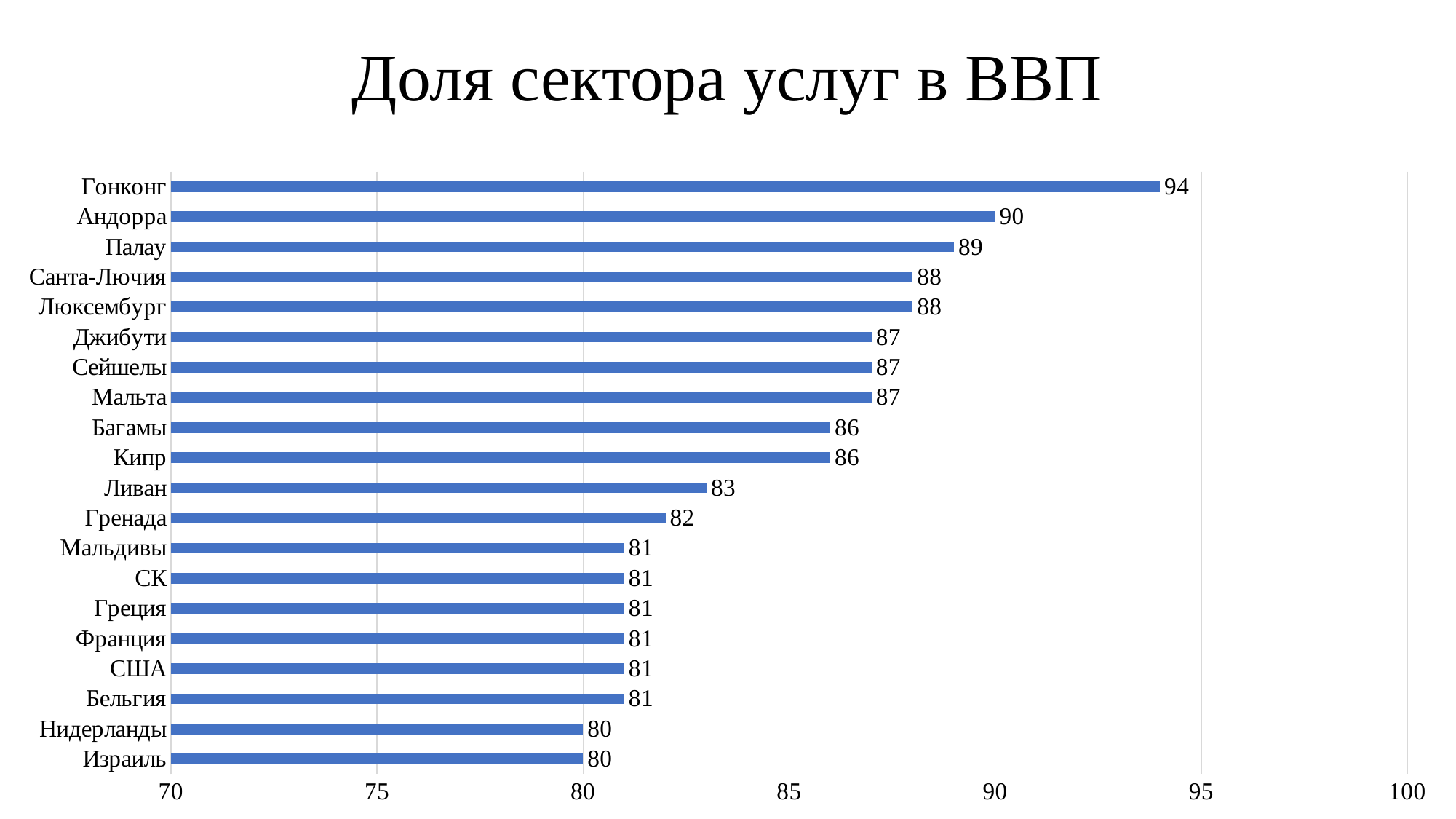
What is the difference between the values for Гонконг and Андорра? 4 What is the value for Гонконг? 94 What is the value for Нидерланды? 80 What is the value for Ливан? 83 What kind of chart is shown on the slide? Bar chart How many countries are shown in the chart? 20 What is the difference between the values for Палау and Израиль? 9 Which has a larger value, Мальта or Гренада? Мальта What is the title of the chart? Доля сектора услуг в ВВП Which country has the highest value? Гонконг What is the value for Гренада? 82 Which has a larger value, Кипр or Ливан? Кипр